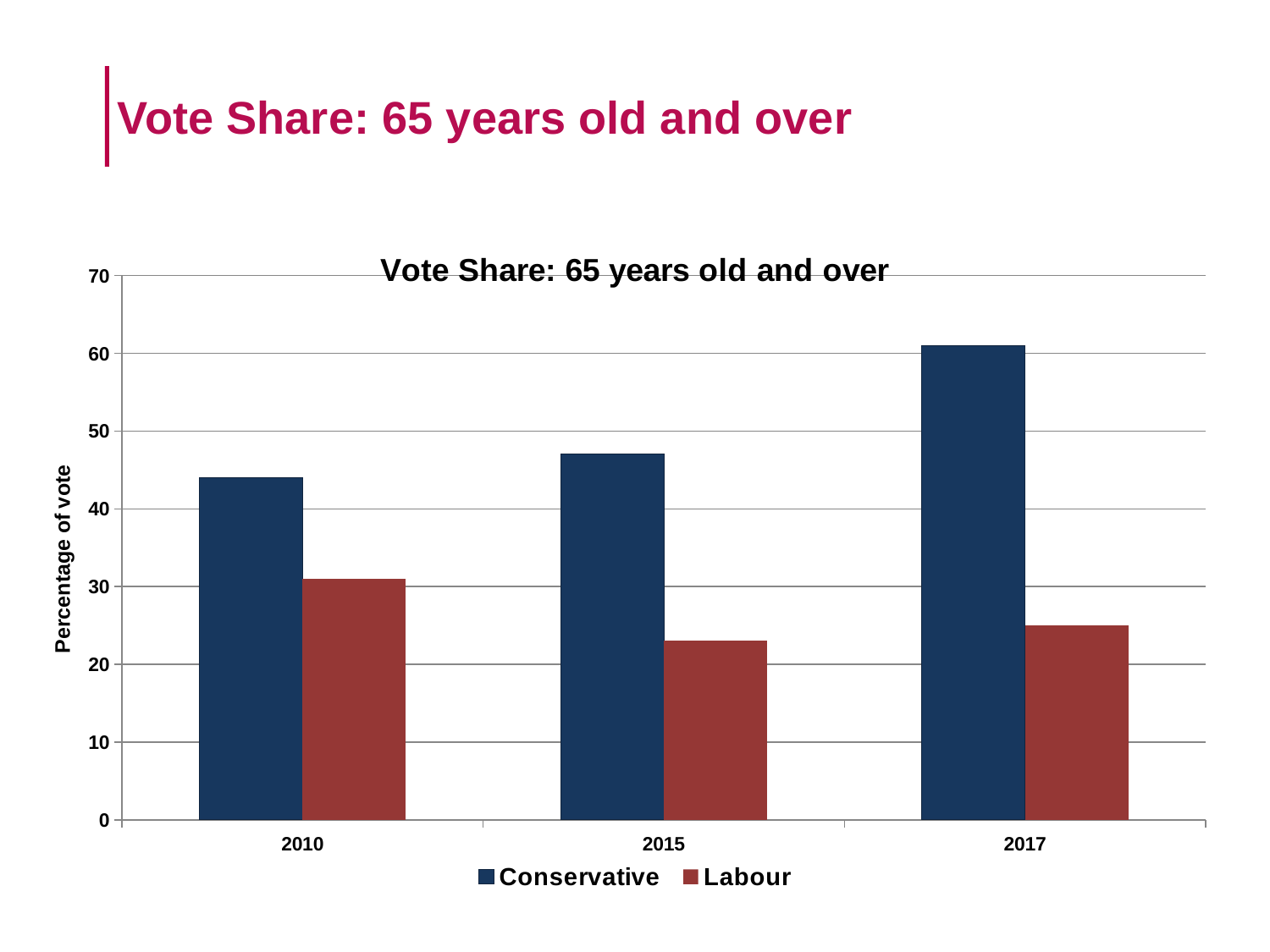
Does the Conservative vote share rise or fall from 2010 to 2017? rise In 2017, which party has the larger vote share, Conservative or Labour? Conservative In which year is the Conservative vote share highest? 2017 What kind of chart is shown on the slide? bar chart In which year is the Labour vote share highest? 2010 How many series does the legend list? 2 What is the label on the vertical axis? Percentage of vote Is the Conservative value for 2017 greater or less than 50? greater Is the Labour value for 2017 greater or less than 20? greater How many years are shown on the x axis? 3 Is the Conservative value for 2010 greater or less than 40? greater